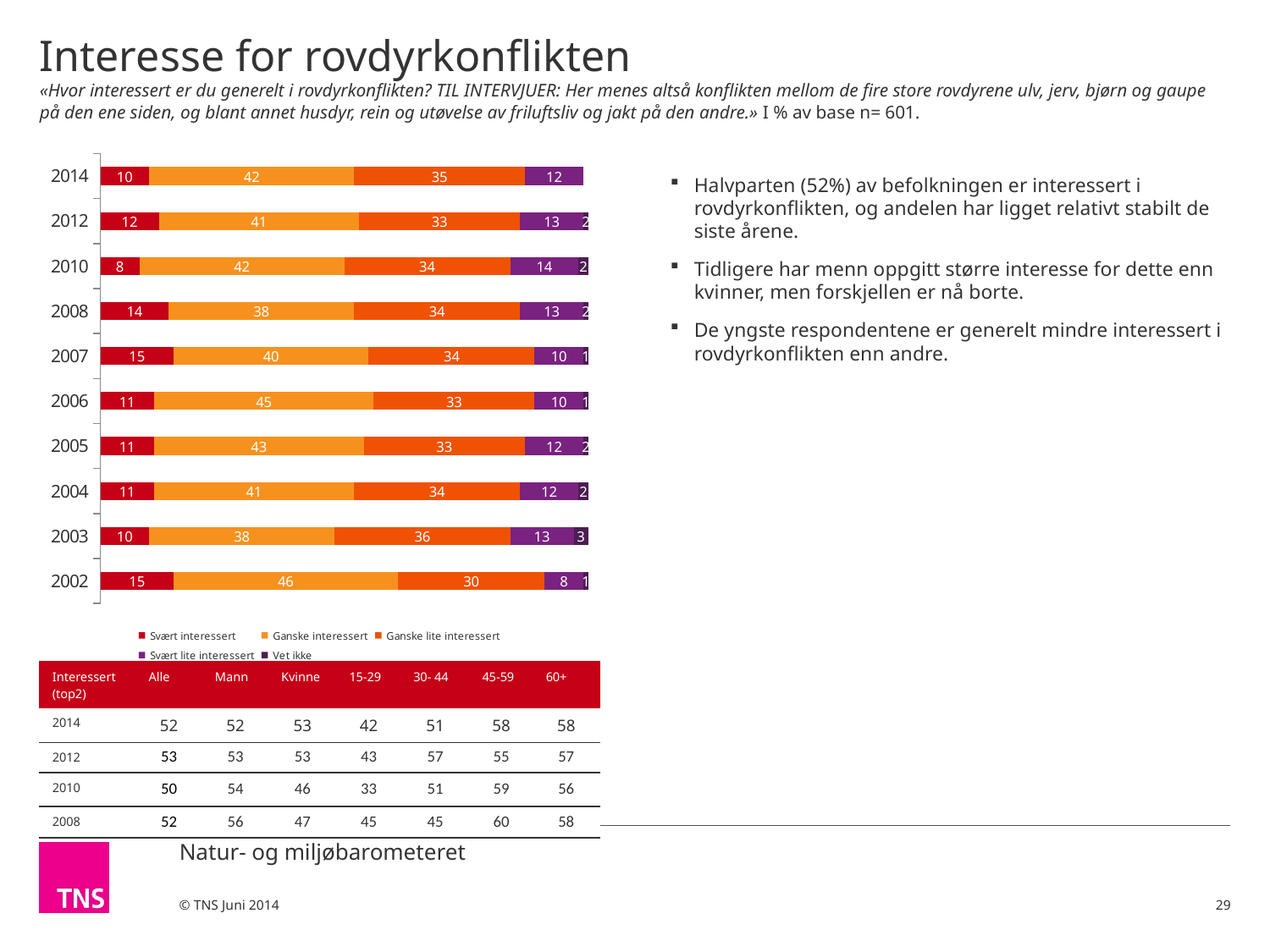
Which year has the highest value for 'Ganske interessert'? 2002 What is the value for 'Svært interessert' in 2010? 8 What is the value for 'Svært lite interessert' in 2002? 8 What is the difference between 'Ganske interessert' and 'Ganske lite interessert' in 2014? 7 What is the value for 'Ganske lite interessert' in 2003? 36 What is the value for 'Ganske interessert' in 2014? 42 Which year has the lowest value for 'Svært interessert'? 2010 What is the total of the stacked bar for 2002? 100 How many years (categories) are plotted in the chart? 10 What kind of chart is shown on the slide? Stacked bar chart Which is larger: 'Svært interessert' in 2008 or 'Svært interessert' in 2006? 2008 How many series does the chart legend list? 5